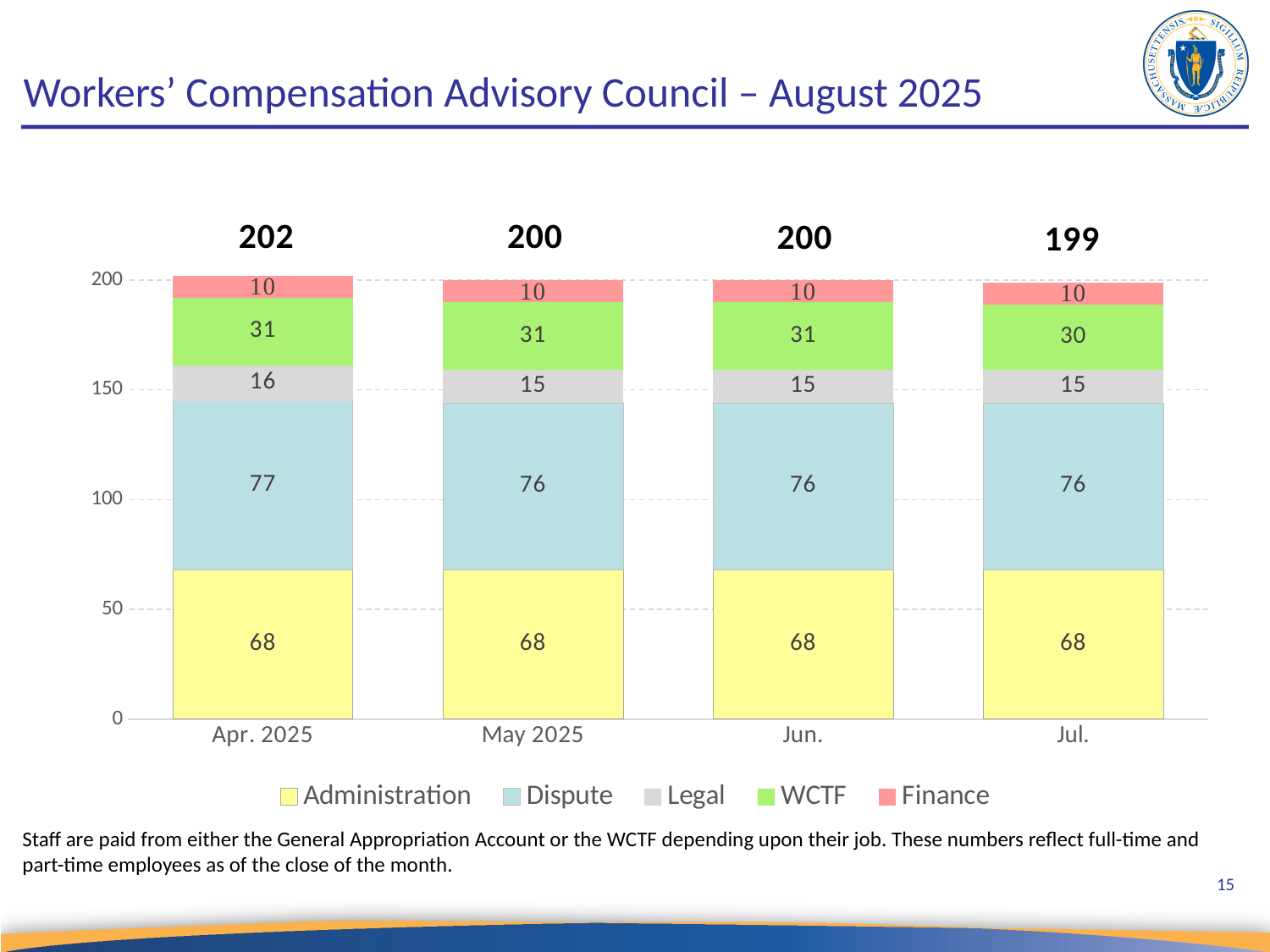
What kind of chart is shown on the slide? Stacked bar chart What is the WCTF value for Jul.? 30 What is the total of the stacked bar for Apr. 2025? 202 How many series does the legend list? 5 Which month has the highest total? Apr. 2025 How many months are shown on the x axis? 4 What is the Dispute value for Apr. 2025? 77 Which month has the lowest total? Jul. What is the Legal value for May 2025? 15 Is the Dispute value for Apr. 2025 larger than the Dispute value for May 2025? Yes What is the total of the stacked bar for Jul.? 199 What is the difference between the Legal value for Apr. 2025 and the Legal value for Jun.? 1